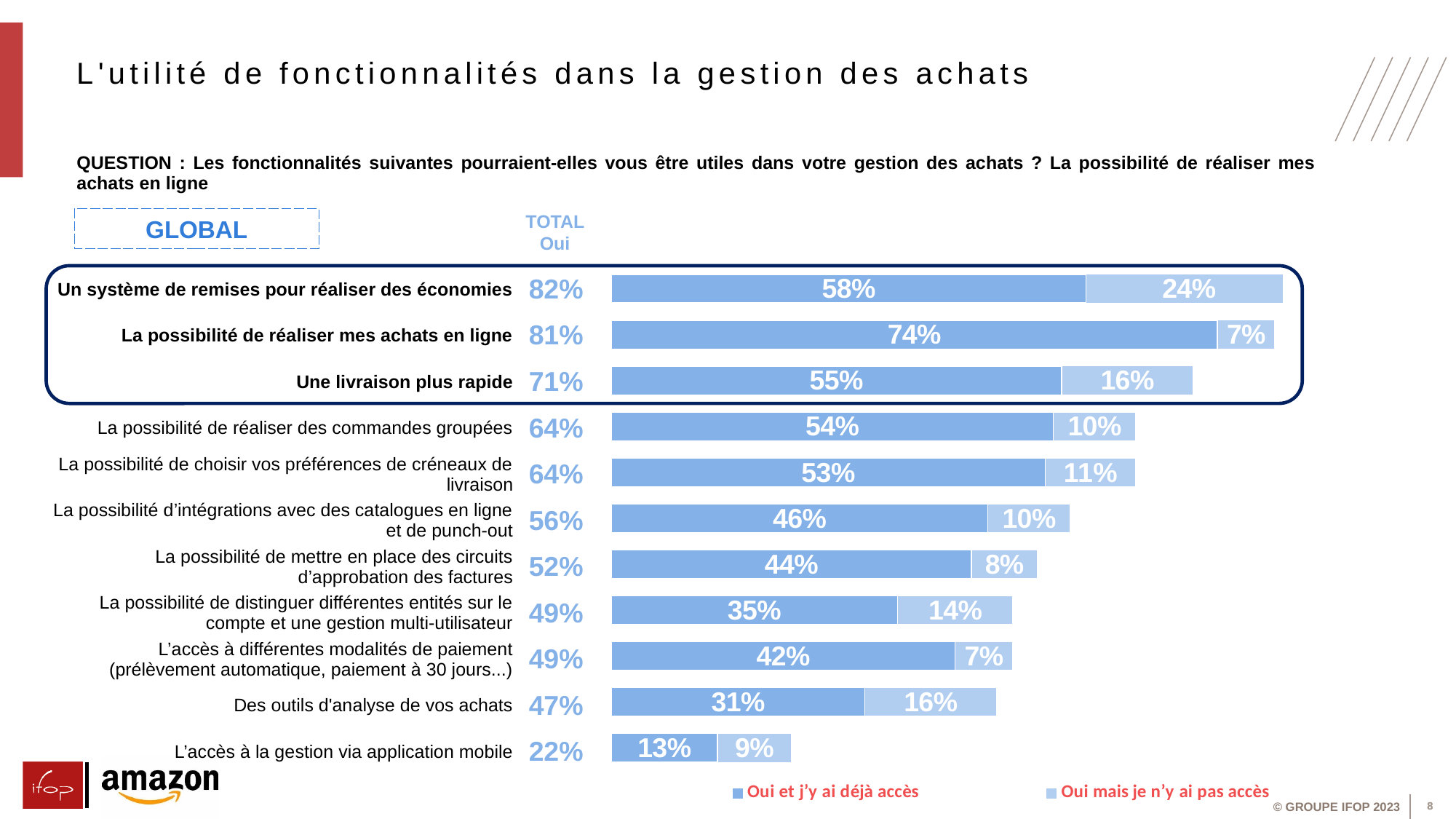
How many series does the legend list? 2 What is the value of "Oui et j'y ai déjà accès" for "La possibilité de réaliser mes achats en ligne"? 74% Which is larger: the "Oui mais je n'y ai pas accès" value for "Des outils d'analyse de vos achats" or for "L'accès à différentes modalités de paiement"? Des outils d'analyse de vos achats What kind of chart is shown on the slide? Stacked bar chart Which category has the lowest TOTAL Oui value? L'accès à la gestion via application mobile How many categories (fonctionnalités) are plotted in the chart? 11 Which series is shown in the darker blue colour? Oui et j'y ai déjà accès What is the difference between the "Oui et j'y ai déjà accès" values for "Un système de remises pour réaliser des économies" and "Une livraison plus rapide"? 3% What is the value of "Oui mais je n'y ai pas accès" for "Un système de remises pour réaliser des économies"? 24% What is the TOTAL Oui value for "Une livraison plus rapide"? 71% Which category has the highest "Oui et j'y ai déjà accès" value? La possibilité de réaliser mes achats en ligne What is the total of the stacked bar for "La possibilité de réaliser des commandes groupées"? 64%